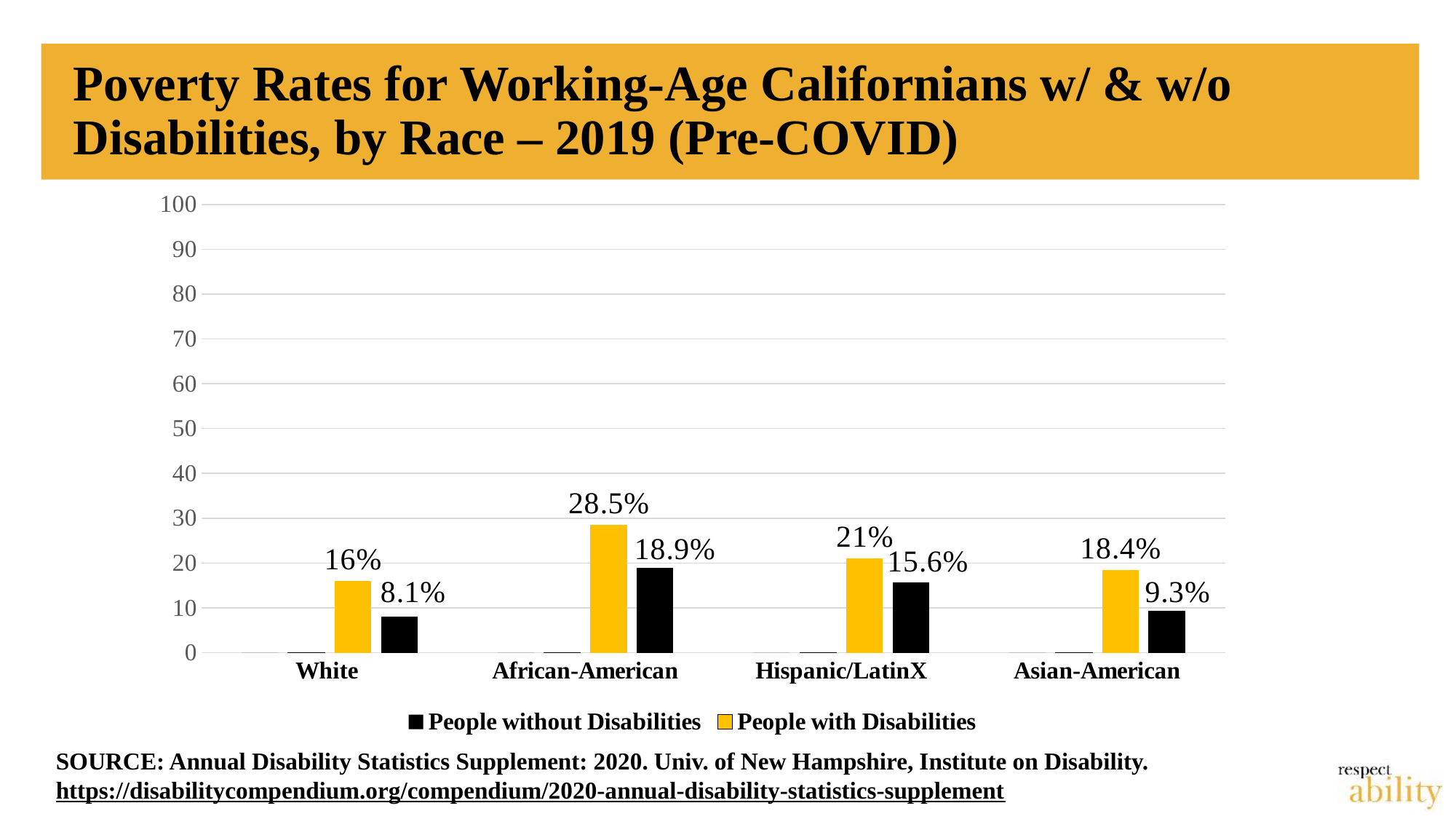
What is the poverty rate for White people with disabilities? 16% What is the difference between the poverty rates for Hispanic/LatinX people with and without disabilities? 5.4% Which racial group has the highest poverty rate for people with disabilities? African-American What is the poverty rate for African-American people without disabilities? 18.9% What is the difference between the poverty rates for Asian-American people with and without disabilities? 9.1% What is the poverty rate for Asian-American people without disabilities? 9.3% How many series does the legend list? 2 What kind of chart is shown on the slide? Bar chart How many racial groups are shown on the x axis? 4 Which racial group has the lowest poverty rate for people without disabilities? White Which is larger: the poverty rate for White people with disabilities or for Hispanic/LatinX people without disabilities? White people with disabilities Is the poverty rate for African-American people with disabilities greater or less than 30? less